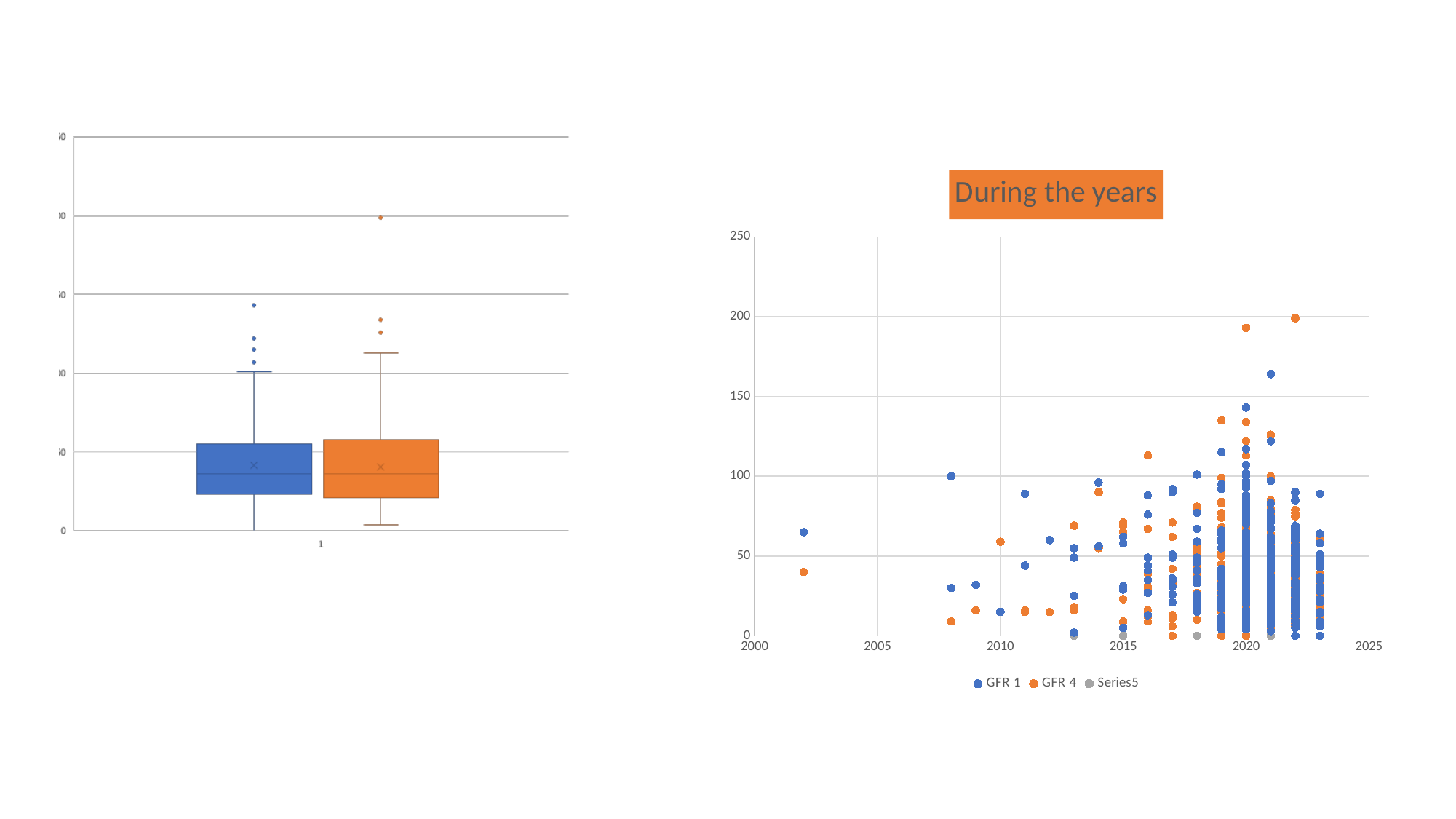
In the "During the years" chart, is the GFR 1 point at 2002 greater or less than 50? greater In the "During the years" chart, is the highest GFR 4 point greater or less than 150? greater What are the series names in the legend of the "During the years" chart? GFR 1, GFR 4, Series5 What kind of chart is the chart on the right titled "During the years"? scatter chart In the "During the years" chart, which series has the single highest point, GFR 1 or GFR 4? GFR 4 In the "During the years" chart, what is the highest value shown on the vertical axis? 250 In the "During the years" chart, is the GFR 4 point at 2002 greater or less than 50? less How many series does the legend of the "During the years" chart list? 3 In the "During the years" chart, what is the earliest year shown on the horizontal axis? 2000 In the "During the years" chart, what colour are the GFR 4 points? orange What kind of chart is the chart on the left of the slide? box and whisker chart